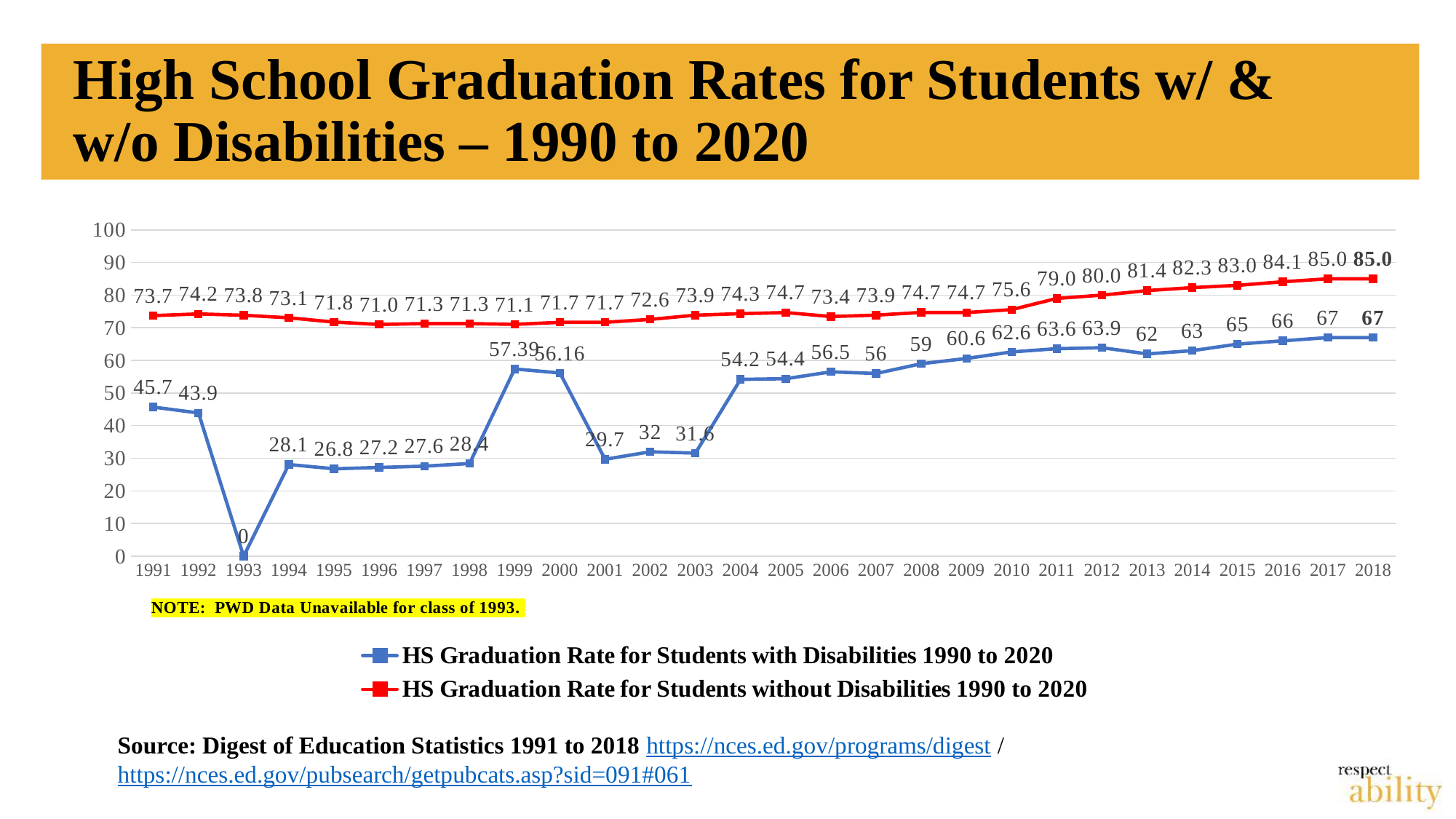
Which is larger: the graduation rate for students with disabilities in 2004 or in 2001? 2004 What kind of chart is shown on the slide? Line chart What is the HS graduation rate for students with disabilities in 2010? 62.6 What is the HS graduation rate for students with disabilities in 1999? 57.39 In which year is the HS graduation rate for students without disabilities lowest? 1996 What is the difference between the 2012 and 2013 graduation rates for students with disabilities? 1.9 Is the graduation rate for students without disabilities in 2014 greater or less than 80? greater How many series does the legend list? 2 What is the HS graduation rate for students without disabilities in 2011? 79.0 What is the difference between the graduation rates for students without disabilities and students with disabilities in 2018? 18.0 Excluding 1993, in which year is the HS graduation rate for students with disabilities lowest? 1995 How many years are shown on the x axis? 28